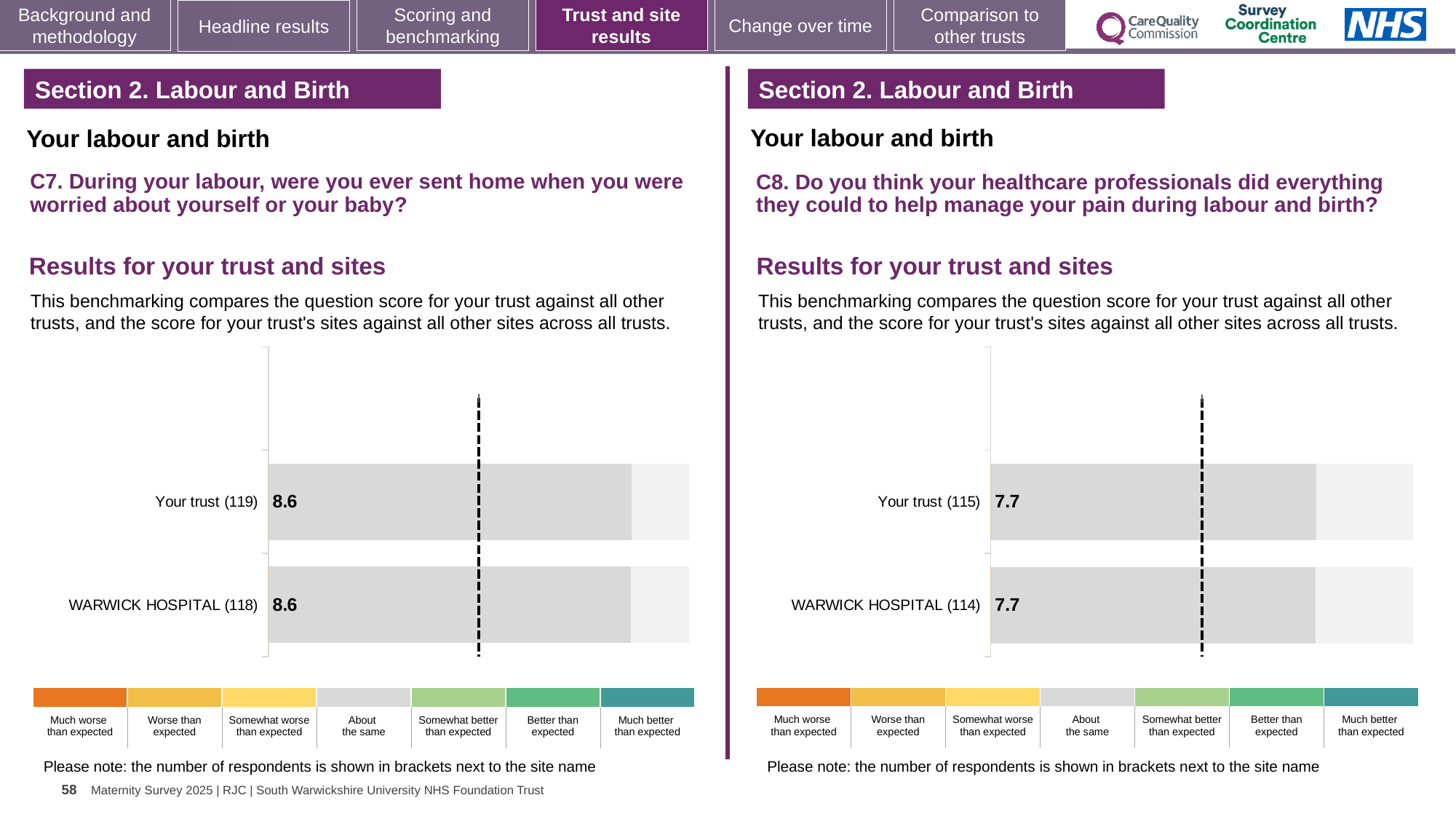
What kind of chart is used on the left (C7)? Bar chart On the right chart (C8), what is the score for Your trust? 7.7 On the right chart (C8), how many respondents are shown in brackets for Your trust? 115 How many bars are plotted on the left chart (C7)? 2 How many bars are plotted on the right chart (C8)? 2 Is the score for Your trust on the left chart (C7) larger or smaller than the score for Your trust on the right chart (C8)? Larger On the left chart (C7), what is the score for Your trust? 8.6 On the right chart (C8), what is the difference between the score for Your trust and the score for WARWICK HOSPITAL? 0 On the left chart (C7), what is the difference between the score for Your trust and the score for WARWICK HOSPITAL? 0 On the left chart (C7), what is the score for WARWICK HOSPITAL? 8.6 On the left chart (C7), how many respondents are shown in brackets for WARWICK HOSPITAL? 118 On the right chart (C8), what is the score for WARWICK HOSPITAL? 7.7